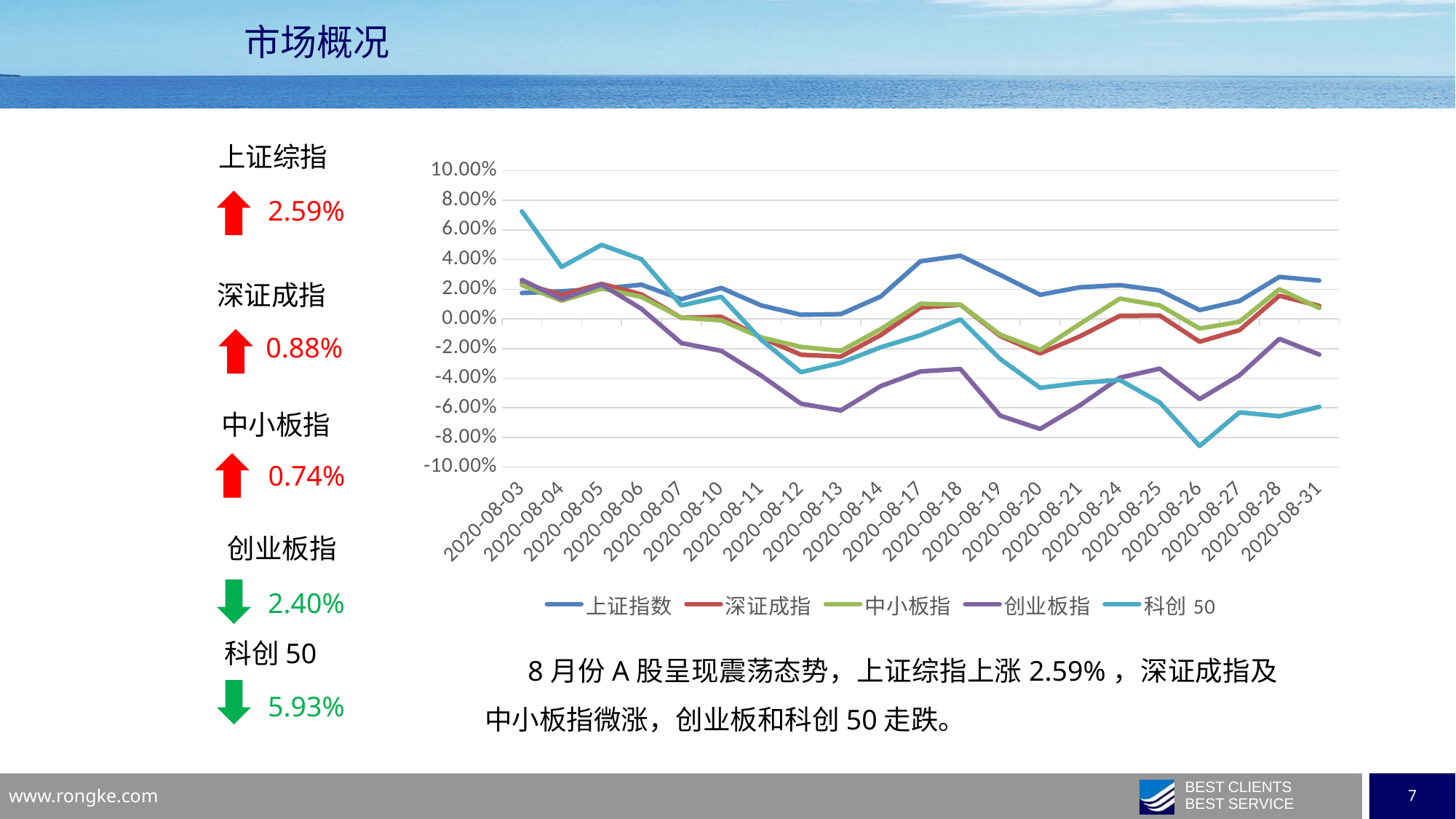
Which series has the highest value on 2020-08-03? 科创 50 Is the value for 科创 50 on 2020-08-26 greater or less than -8.00%? less What colour is the 创业板指 line in the chart? purple Which series has the lowest value on 2020-08-31? 科创 50 Which series has the lowest value on 2020-08-13? 创业板指 Is the value for 科创 50 on 2020-08-03 greater or less than 6.00%? greater How many dates are plotted along the x axis of the chart? 21 What kind of chart is shown on the slide? line chart On 2020-08-31, which is larger: the value for 上证指数 or the value for 创业板指? 上证指数 How many series does the chart legend list? 5 Is the value for 创业板指 on 2020-08-20 greater or less than -6.00%? less Does the 科创 50 line rise or fall overall from 2020-08-03 to 2020-08-31? fall